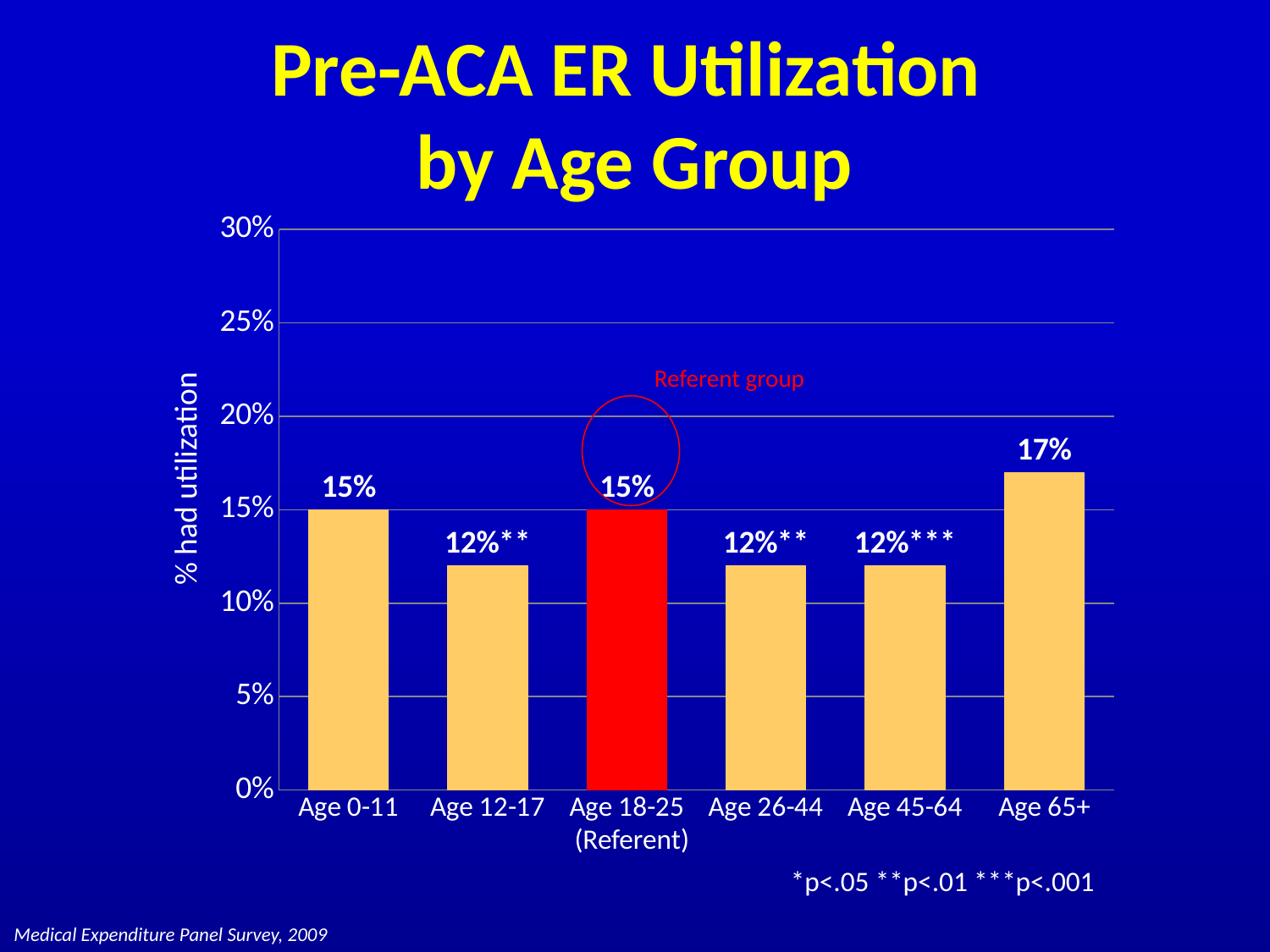
Which age group has the highest ER utilization? Age 65+ What is the value for Age 65+? 17% How many age groups are shown on the chart? 6 What kind of chart is shown on the slide? bar chart What is the difference between the values for Age 0-11 and Age 12-17? 3% What is the value for Age 0-11? 15% Which age group's bar is coloured red? Age 18-25 (Referent) Is the value for Age 65+ greater or less than 20%? less Which is larger, the value for Age 26-44 or the value for Age 65+? Age 65+ What is the difference between the values for Age 65+ and Age 18-25 (Referent)? 2% What is the title of the chart? Pre-ACA ER Utilization by Age Group What is the value for Age 45-64? 12%